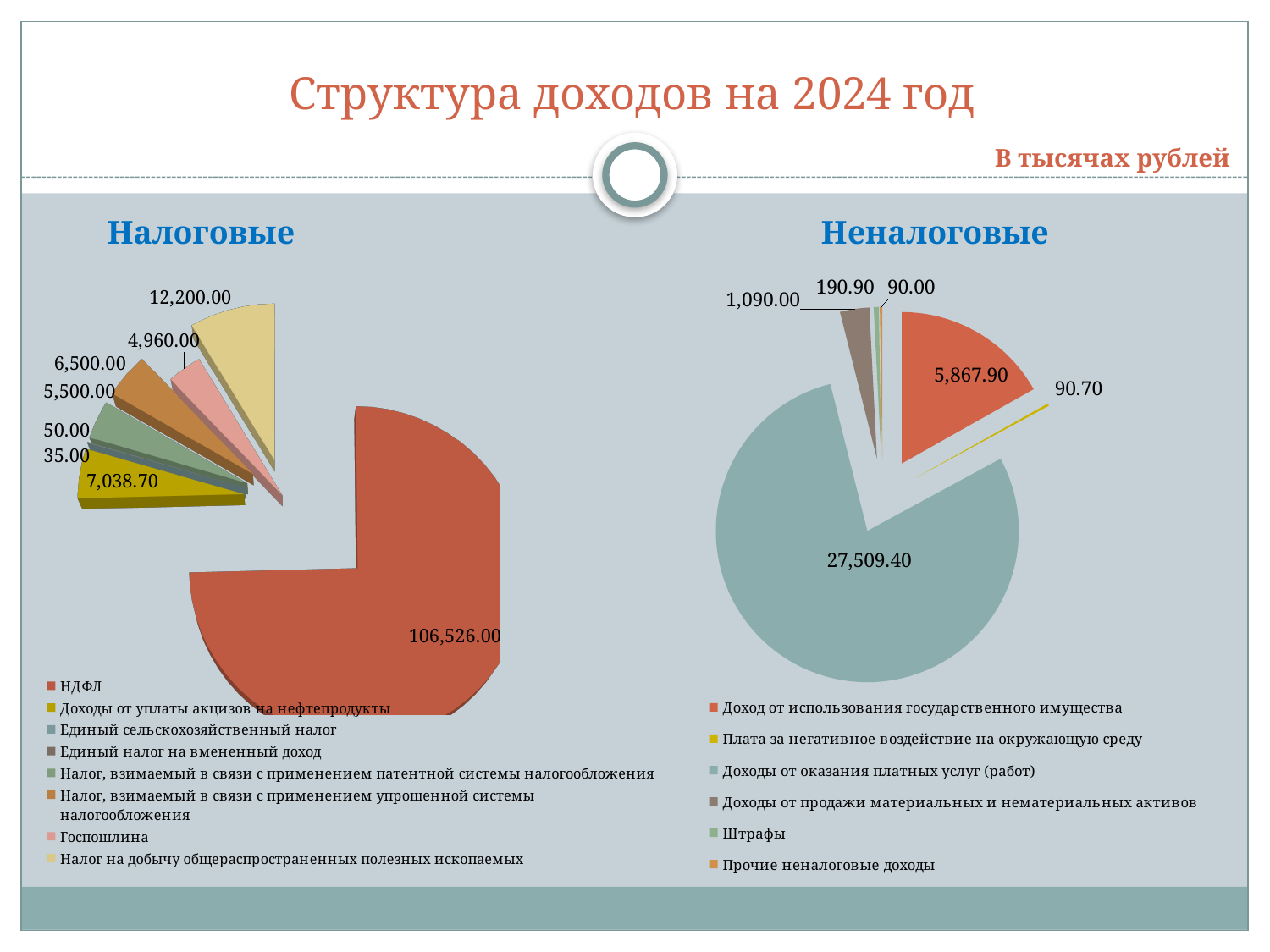
In the "Неналоговые" chart, what is the value for Доход от использования государственного имущества? 5,867.90 In the "Налоговые" chart, what is the value for Налог на добычу общераспространенных полезных ископаемых? 12,200.00 In the "Налоговые" chart, what is the value for Госпошлина? 4,960.00 In the "Неналоговые" chart, what is the value for Доходы от оказания платных услуг (работ)? 27,509.40 In the "Налоговые" chart, what is the value for НДФЛ? 106,526.00 In the "Неналоговые" chart, which is larger: Доходы от продажи материальных и нематериальных активов or Штрафы? Доходы от продажи материальных и нематериальных активов In the "Налоговые" chart, how many categories does the legend list? 8 In the "Налоговые" chart, which category has the largest slice? НДФЛ What type of chart is used for the "Налоговые" chart? pie chart In the "Неналоговые" chart, how many categories does the legend list? 6 In the "Неналоговые" chart, which category has the largest slice? Доходы от оказания платных услуг (работ) In the "Налоговые" chart, what is the difference between Налог на добычу общераспространенных полезных ископаемых (12,200.00) and Доходы от уплаты акцизов на нефтепродукты (7,038.70)? 5,161.30